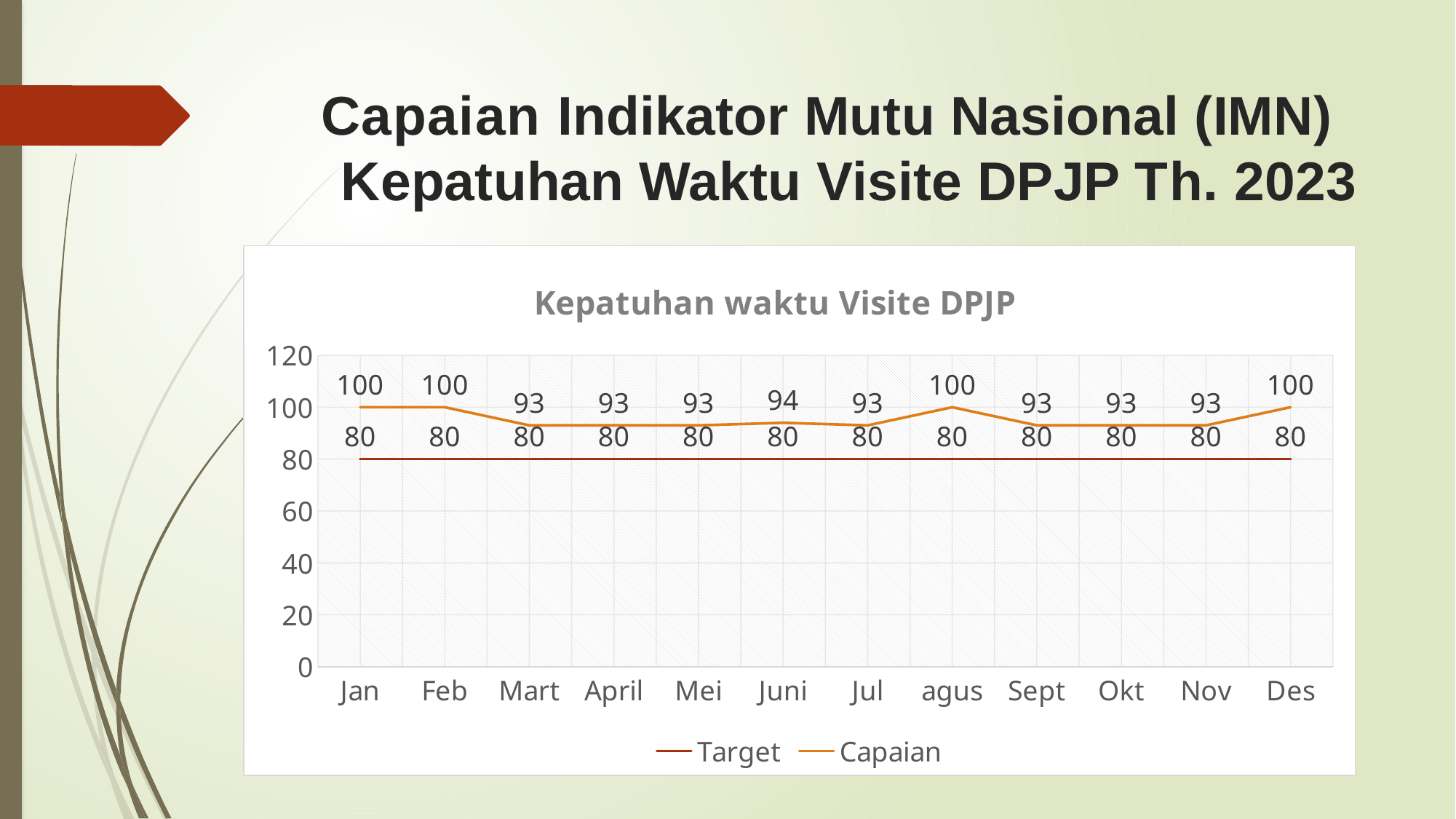
Which is larger, the Capaian value for Feb or the Capaian value for Mart? Feb What is the difference between the Capaian values for Juni and Jul? 1 How many months are shown on the x axis? 12 What is the Capaian value for Juni? 94 What is the title of the chart? Kepatuhan waktu Visite DPJP What is the Target value for Mart? 80 What is the Capaian value for Sept? 93 What is the difference between the Capaian and Target values for Des? 20 Which months have the highest Capaian value? Jan, Feb, agus, Des How many series does the legend list? 2 Is the Capaian value for Okt greater or less than 80? greater What kind of chart is shown on the slide? line chart